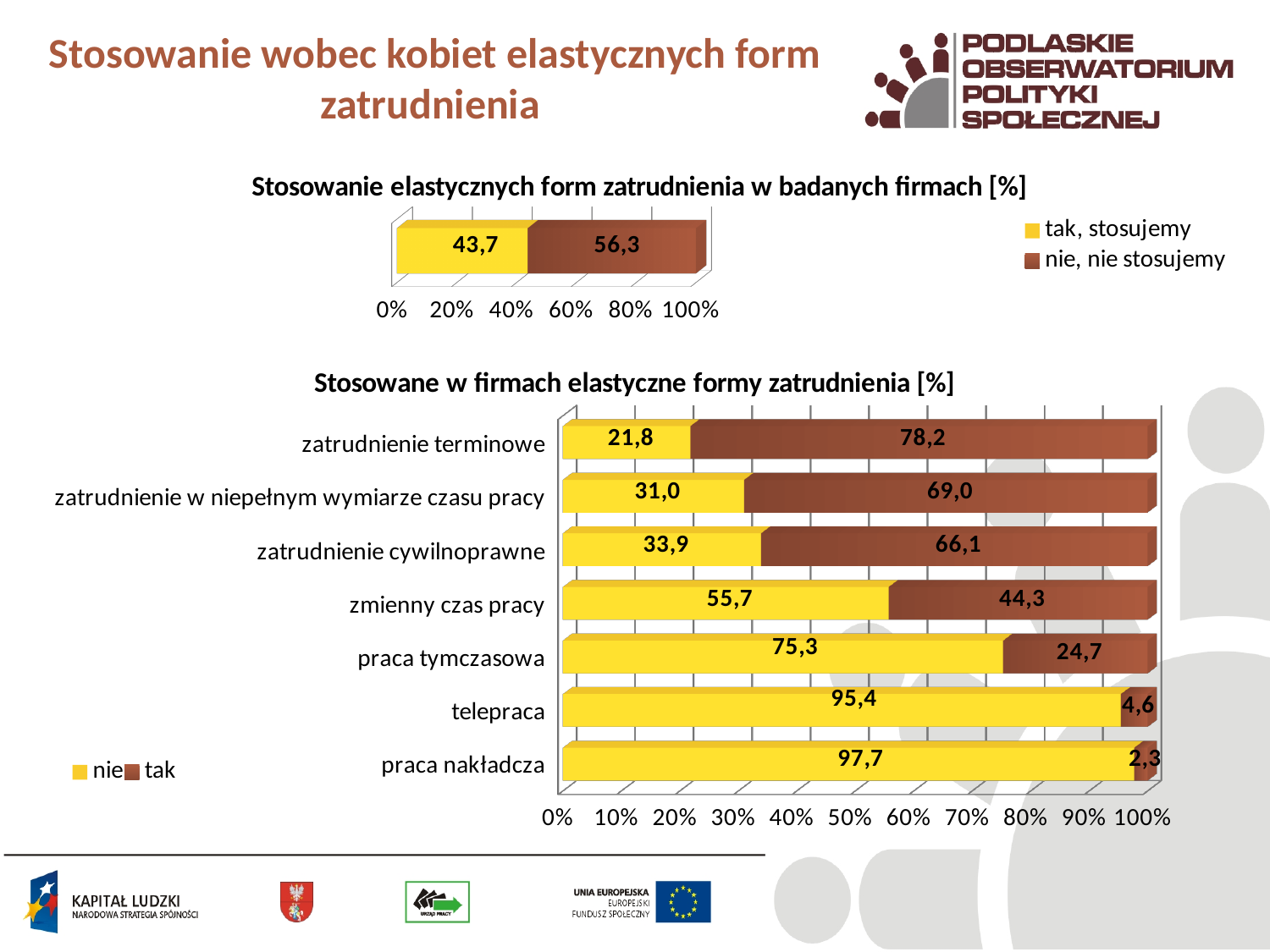
In the bottom chart, how many series does the legend list? 2 In the bottom chart, what is the difference between the 'nie' and 'tak' values for 'zmienny czas pracy'? 11,4 In the bottom chart 'Stosowane w firmach elastyczne formy zatrudnienia [%]', which category has the lowest 'tak' value? praca nakładcza In the bottom chart 'Stosowane w firmach elastyczne formy zatrudnienia [%]', what is the 'tak' value for 'zatrudnienie terminowe'? 78,2 In the bottom chart 'Stosowane w firmach elastyczne formy zatrudnienia [%]', which category has the highest 'tak' value? zatrudnienie terminowe In the bottom chart 'Stosowane w firmach elastyczne formy zatrudnienia [%]', what is the 'nie' value for 'telepraca'? 95,4 What kind of chart is the bottom chart 'Stosowane w firmach elastyczne formy zatrudnienia [%]'? stacked bar chart In the top chart, which is larger: 'tak, stosujemy' or 'nie, nie stosujemy'? nie, nie stosujemy In the top chart 'Stosowanie elastycznych form zatrudnienia w badanych firmach [%]', what is the value for 'nie, nie stosujemy'? 56,3 In the bottom chart, which colour represents the 'nie' series? yellow In the bottom chart, how many categories are shown? 7 In the top chart 'Stosowanie elastycznych form zatrudnienia w badanych firmach [%]', what is the value for 'tak, stosujemy'? 43,7